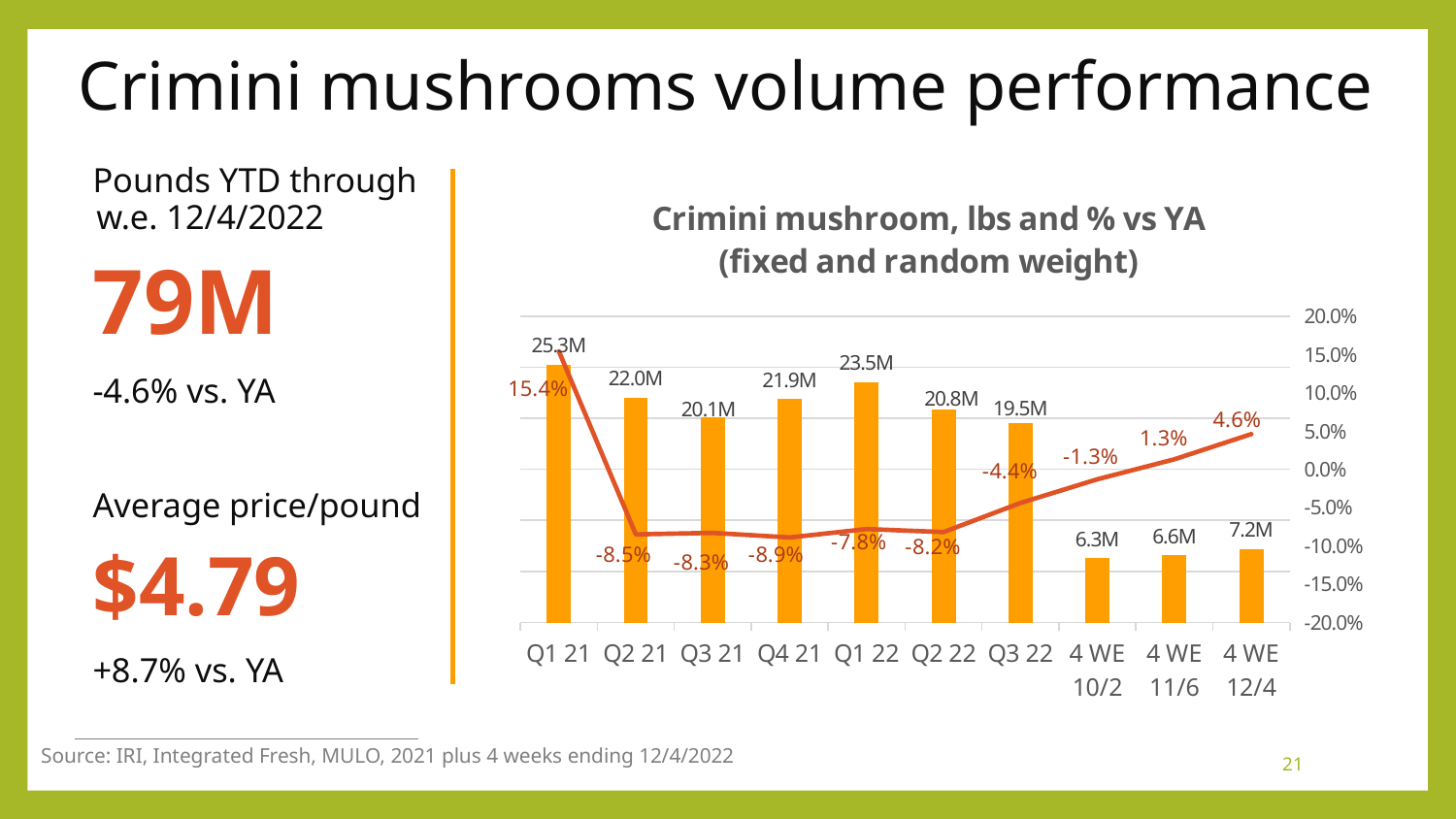
What is the title of the chart? Crimini mushroom, lbs and % vs YA (fixed and random weight) What is the difference in pounds between Q1 22 and Q2 22? 2.7M What is the volume in pounds for Q1 21? 25.3M Which period has the lowest volume in pounds? 4 WE 10/2 Which period has the highest volume in pounds? Q1 21 What is the % vs YA value for Q3 22? -4.4% What kind of chart is this? Combination bar and line chart Which period has the lowest % vs YA value? Q4 21 Which is larger, the volume for Q2 21 or Q4 21? Q2 21 What is the volume in pounds for the 4 WE 12/4 period? 7.2M Does the % vs YA line rise or fall from Q3 22 to 4 WE 12/4? Rise How many periods are shown on the x axis? 10